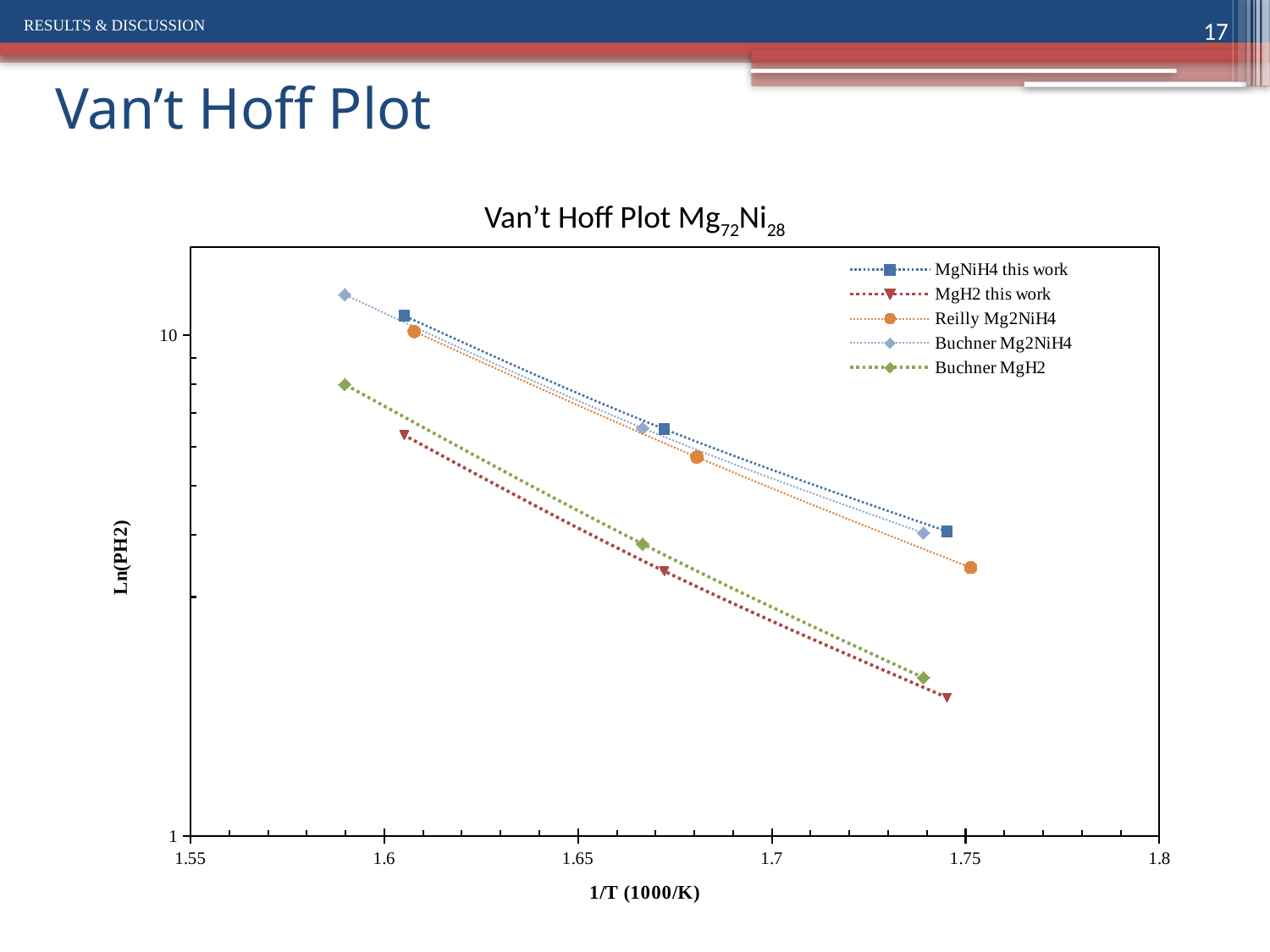
Is the value for the rightmost MgH2 this work point greater or less than 10? less Is the value for the leftmost MgNiH4 this work point greater or less than 10? greater How many data points are plotted for the MgH2 this work series? 3 What kind of chart is shown on the slide? scatter chart What is the title of the chart? Van't Hoff Plot Mg72Ni28 Do the values for the Buchner MgH2 series rise or fall as 1/T increases along the x axis? fall How many data points are plotted for the Reilly Mg2NiH4 series? 3 Do the values for the MgNiH4 this work series rise or fall as 1/T increases along the x axis? fall At the leftmost points near 1/T = 1.59, which series has the larger value: Buchner Mg2NiH4 or Buchner MgH2? Buchner Mg2NiH4 At the rightmost points near 1/T = 1.745, which series has the larger value: MgNiH4 this work or MgH2 this work? MgNiH4 this work What is the label of the x axis? 1/T (1000/K) How many series does the legend list? 5